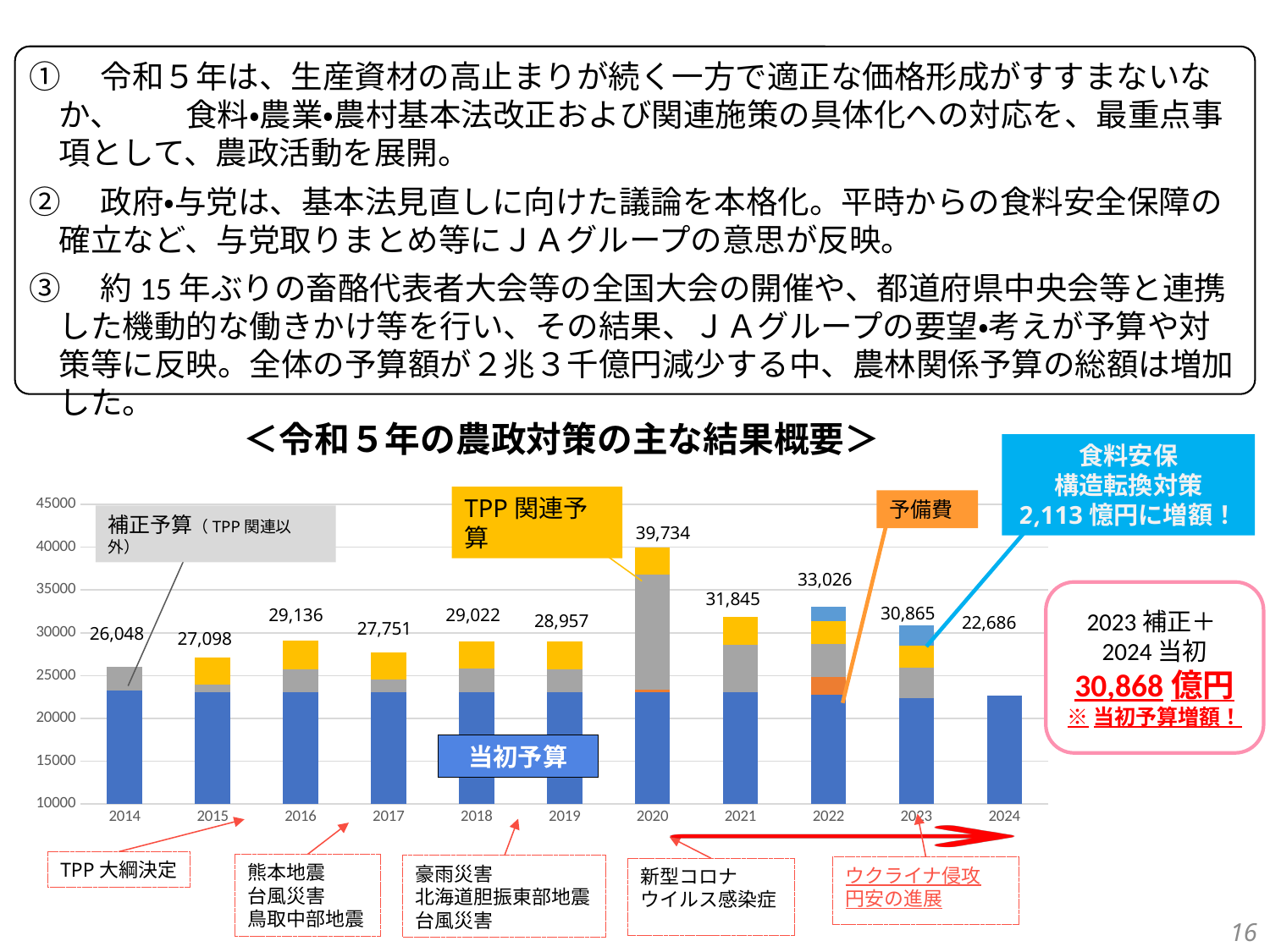
Which year has a larger labeled total, 2016 or 2017? 2016 What total value is labeled on the bar for 2022? 33,026 What total value is labeled on the bar for 2020? 39,734 Which year has the highest labeled total? 2020 Is the blue 当初予算 portion of the 2014 bar greater or less than 20000? greater What is the title of the chart? ＜令和５年の農政対策の主な結果概要＞ How many years are shown on the x axis of the chart? 11 What kind of chart is shown on the slide? Stacked bar chart What total value is labeled on the bar for 2024? 22,686 Which year has the lowest labeled total? 2024 What total value is labeled on the bar for 2014? 26,048 What is the difference between the labeled totals for 2020 and 2021? 7,889